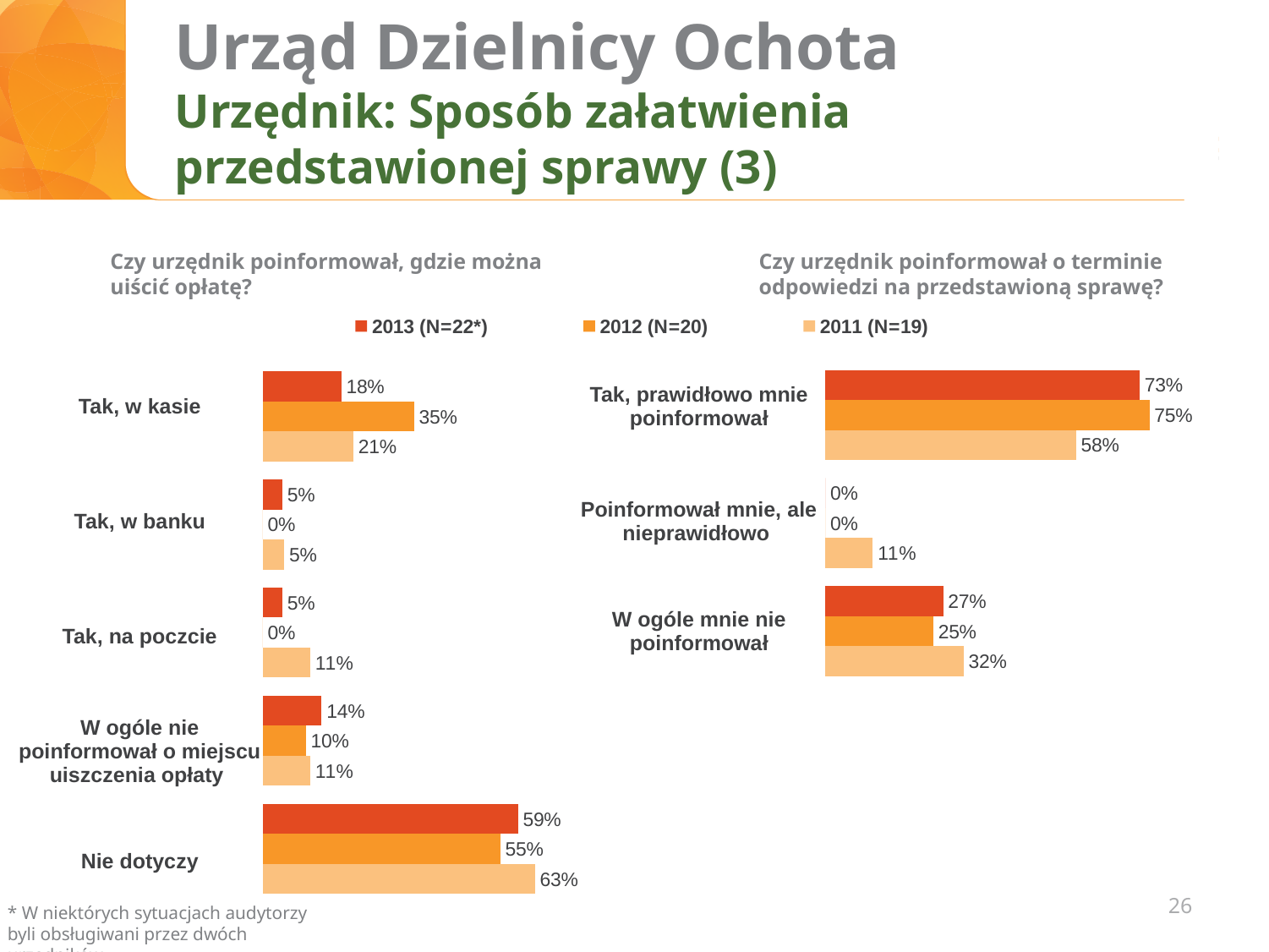
In the left chart (Czy urzędnik poinformował, gdzie można uiścić opłatę?), what is the difference between the 2012 and 2013 values for 'Tak, w kasie'? 17 percentage points In the right chart (Czy urzędnik poinformował o terminie odpowiedzi...), what is the difference between the 2012 and 2011 values for 'Tak, prawidłowo mnie poinformował'? 17 percentage points In the right chart (Czy urzędnik poinformował o terminie odpowiedzi...), which year has the lowest value for 'Tak, prawidłowo mnie poinformował'? 2011 (N=19) In the left chart (Czy urzędnik poinformował, gdzie można uiścić opłatę?), which category has the highest 2013 value? Nie dotyczy How many series does the legend list? 3 In the right chart (Czy urzędnik poinformował o terminie odpowiedzi...), what is the 2013 value for 'Tak, prawidłowo mnie poinformował'? 73% In the right chart (Czy urzędnik poinformował o terminie odpowiedzi...), which is larger for 'W ogóle mnie nie poinformował': the 2013 value or the 2011 value? 2011 (32%) In the left chart (Czy urzędnik poinformował, gdzie można uiścić opłatę?), what is the 2011 value for 'Nie dotyczy'? 63% In the right chart (Czy urzędnik poinformował o terminie odpowiedzi...), what is the 2011 value for 'Poinformował mnie, ale nieprawidłowo'? 11% In the left chart (Czy urzędnik poinformował, gdzie można uiścić opłatę?), what is the 2012 value for 'Tak, w kasie'? 35% What type of chart is used on this slide? Bar chart How many categories does the left chart (Czy urzędnik poinformował, gdzie można uiścić opłatę?) show? 5